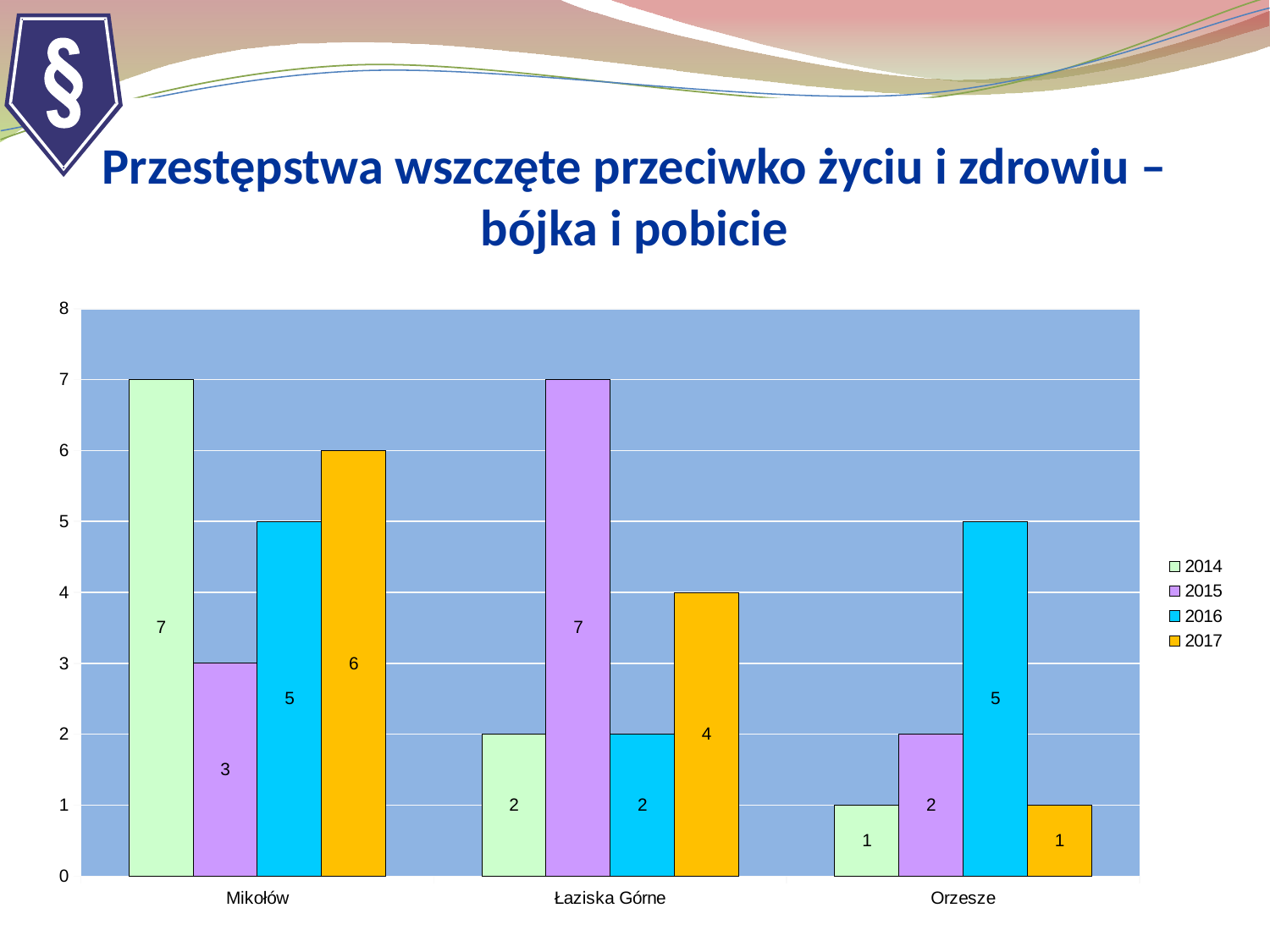
Which category has the lowest value in 2017? Orzesze How many categories are shown on the x axis? 3 How many series does the legend list? 4 Which category has the highest value in 2015? Łaziska Górne What is the value for Orzesze in 2016? 5 Which series is shown in orange in the legend? 2017 What is the value for Mikołów in 2014? 7 What is the value for Łaziska Górne in 2017? 4 Which is larger: the 2016 value for Orzesze or the 2016 value for Łaziska Górne? Orzesze What kind of chart is shown on the slide? bar chart What is the difference between the 2014 and 2015 values for Mikołów? 4 Do the values for Orzesze rise or fall from 2014 to 2016? rise